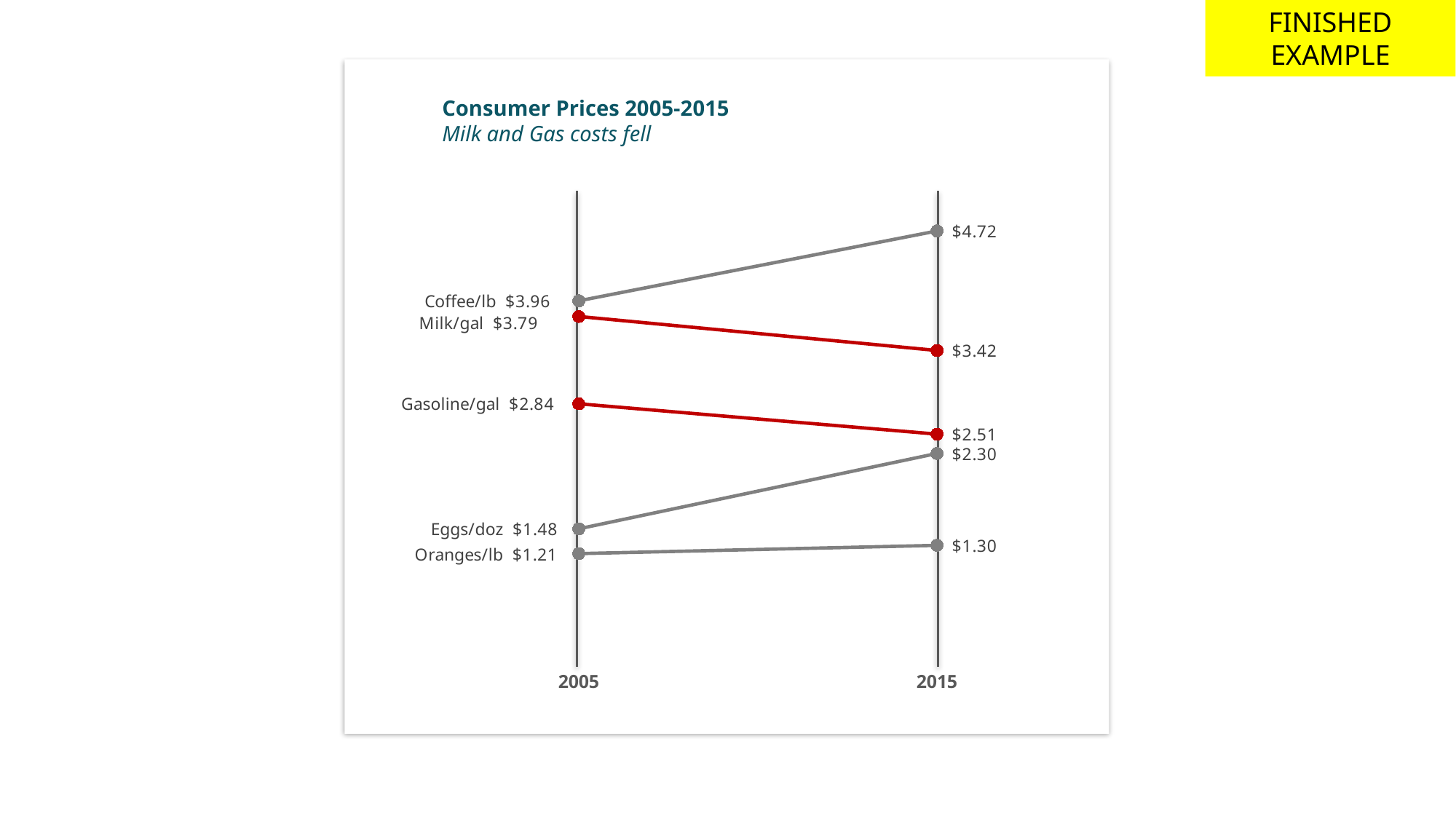
How many items are plotted on the chart? 5 By how much did the price of Eggs/doz change from 2005 to 2015? $0.82 Which item had the lowest price in 2005? Oranges/lb What was the price of Coffee/lb in 2005? $3.96 What was the price of Eggs/doz in 2015? $2.30 Did the price of Milk/gal rise or fall from 2005 to 2015? fall Which item had the highest price in 2015? Coffee/lb What was the price of Milk/gal in 2015? $3.42 What was the price of Gasoline/gal in 2005? $2.84 By how much did the price of Gasoline/gal fall from 2005 to 2015? $0.33 What was the price of Coffee/lb in 2015? $4.72 Which items are drawn in red on the chart? Milk/gal and Gasoline/gal